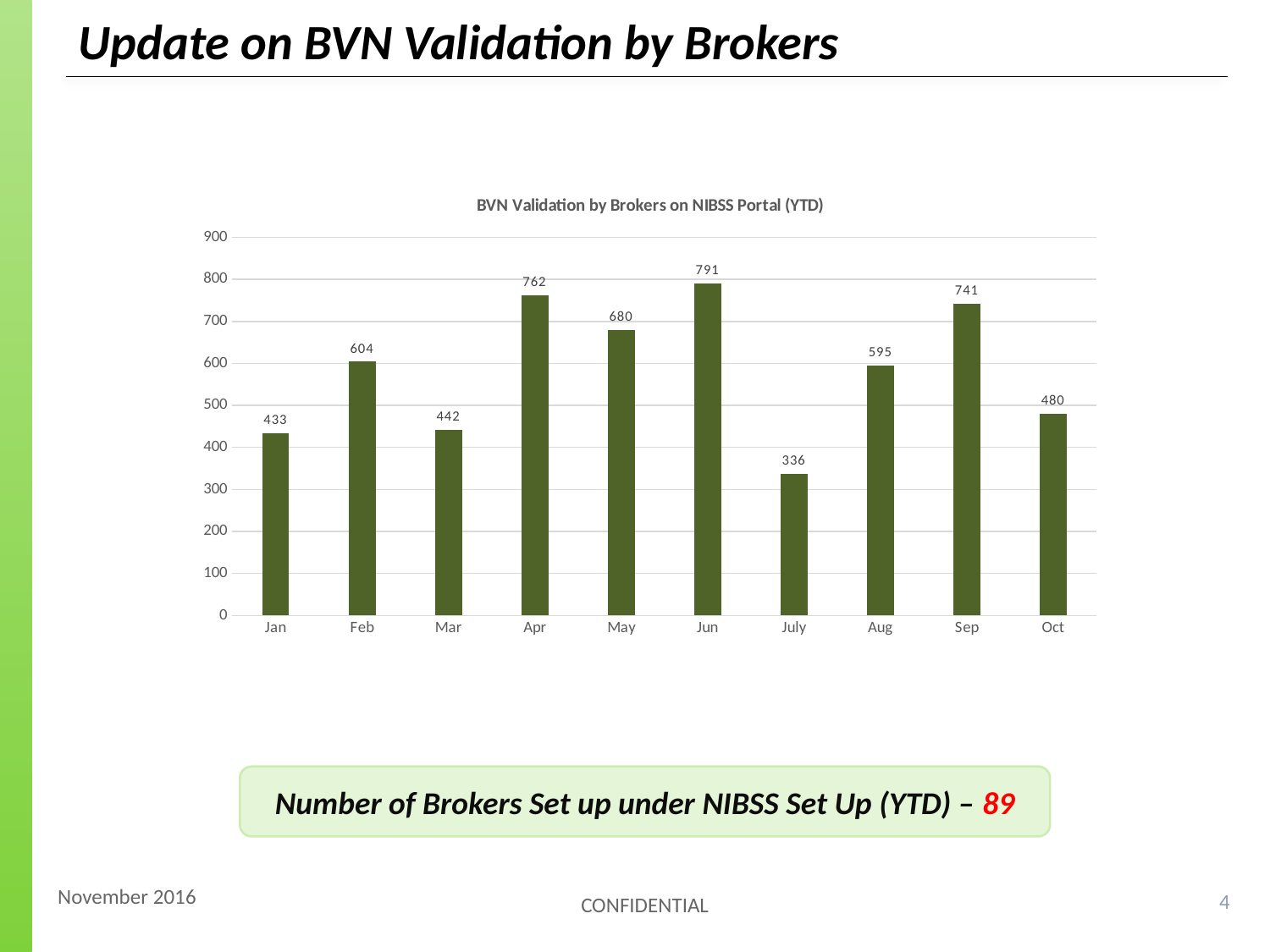
How many months are shown on the x axis? 10 What is the value for Jun? 791 Which is larger, the value for Feb or the value for Aug? Feb Is the value for May greater or less than 600? greater What is the value for Sep? 741 What is the title of the chart? BVN Validation by Brokers on NIBSS Portal (YTD) Which month has the lowest value? July What kind of chart is shown on the slide? bar chart What is the value for Mar? 442 Which month has the highest value? Jun What is the difference between the values for Apr and Jan? 329 Do the values rise or fall from Jun to July? fall